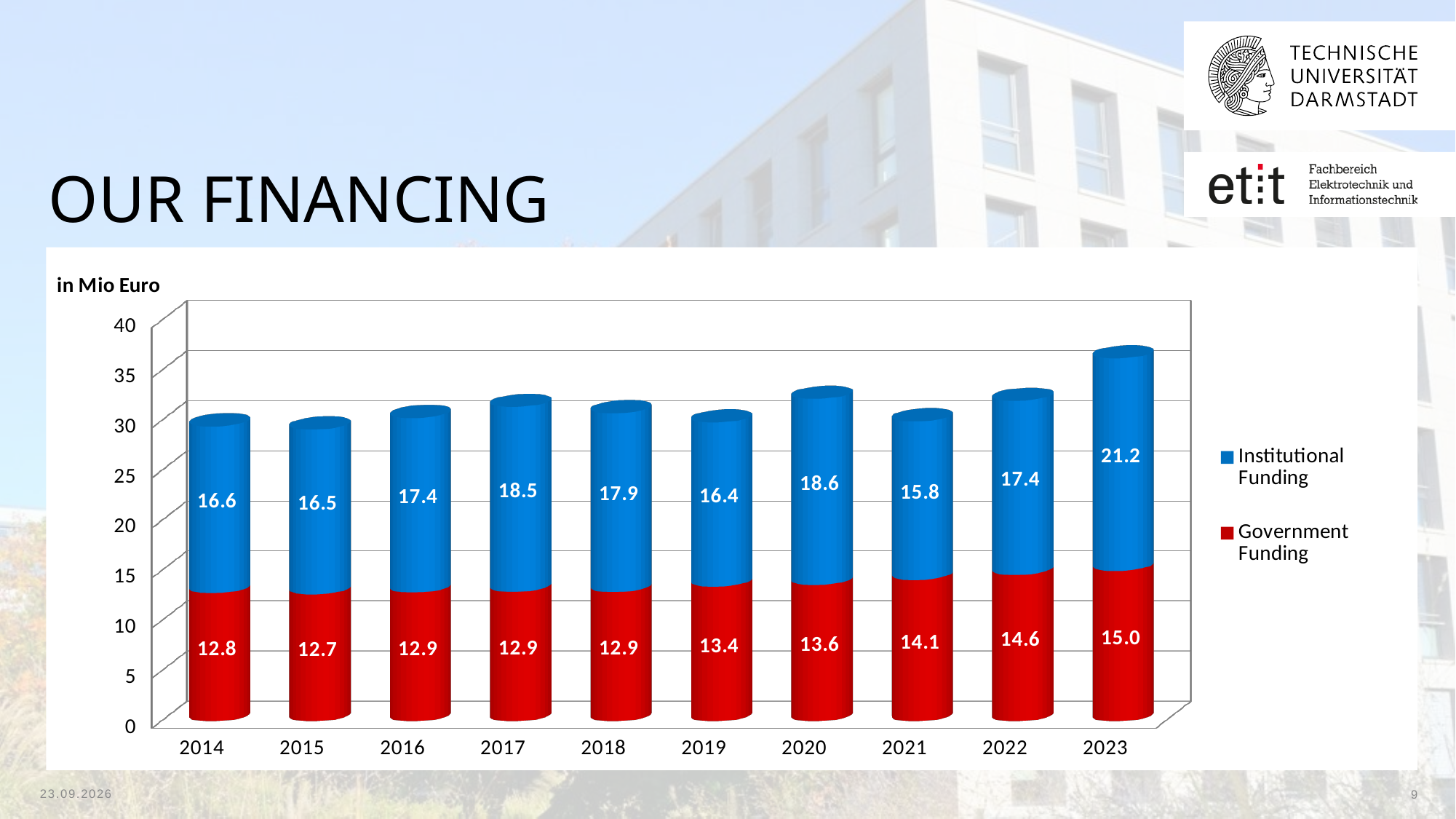
What is the Institutional Funding value for 2023? 21.2 What is the Institutional Funding value for 2017? 18.5 What is the difference between Institutional Funding in 2023 and 2022? 3.8 What is the total of the stacked bar for 2023? 36.2 How many years are shown on the x axis? 10 What is the total of the stacked bar for 2014? 29.4 What is the Government Funding value for 2019? 13.4 What kind of chart is shown on the slide? Stacked bar chart Which year has the highest Government Funding? 2023 Is Institutional Funding larger in 2020 or in 2021? 2020 How many series does the legend list? 2 Which year has the lowest Institutional Funding? 2021